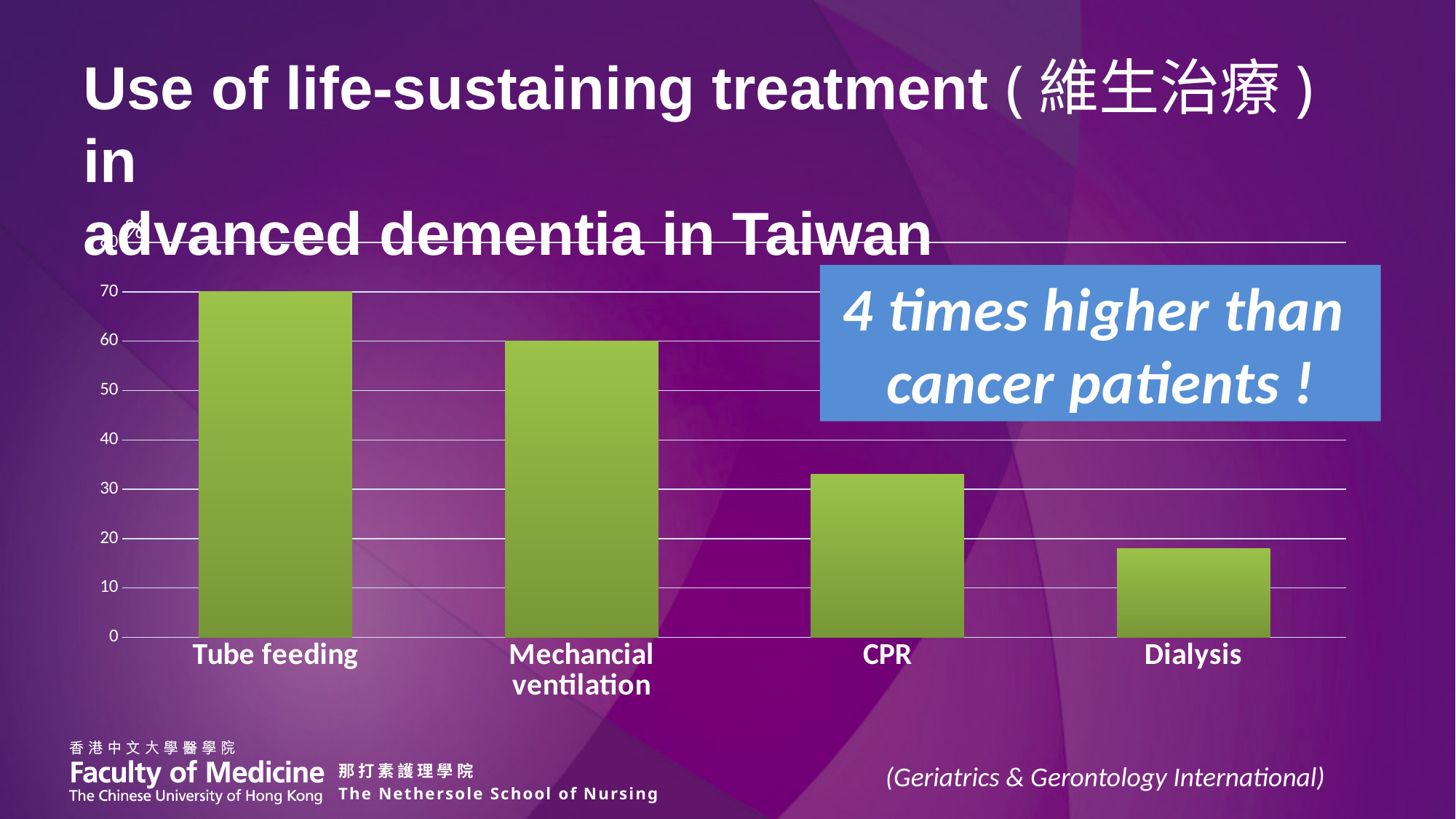
Is the value for Dialysis greater or less than 20? less Is the value for CPR greater or less than 40? less Which category has the highest bar in the chart? Tube feeding What type of chart is shown on the slide? Bar chart What is the value for Tube feeding? 70 Do the bar values rise or fall from left to right across the x axis? Fall Which is larger, the value for CPR or the value for Dialysis? CPR Which category has the lowest bar in the chart? Dialysis What does the blue callout box on the chart say? 4 times higher than cancer patients! What is the value for Mechancial ventilation? 60 What is the difference between the values for Tube feeding and Mechancial ventilation? 10 How many categories are shown on the x axis of the chart? 4